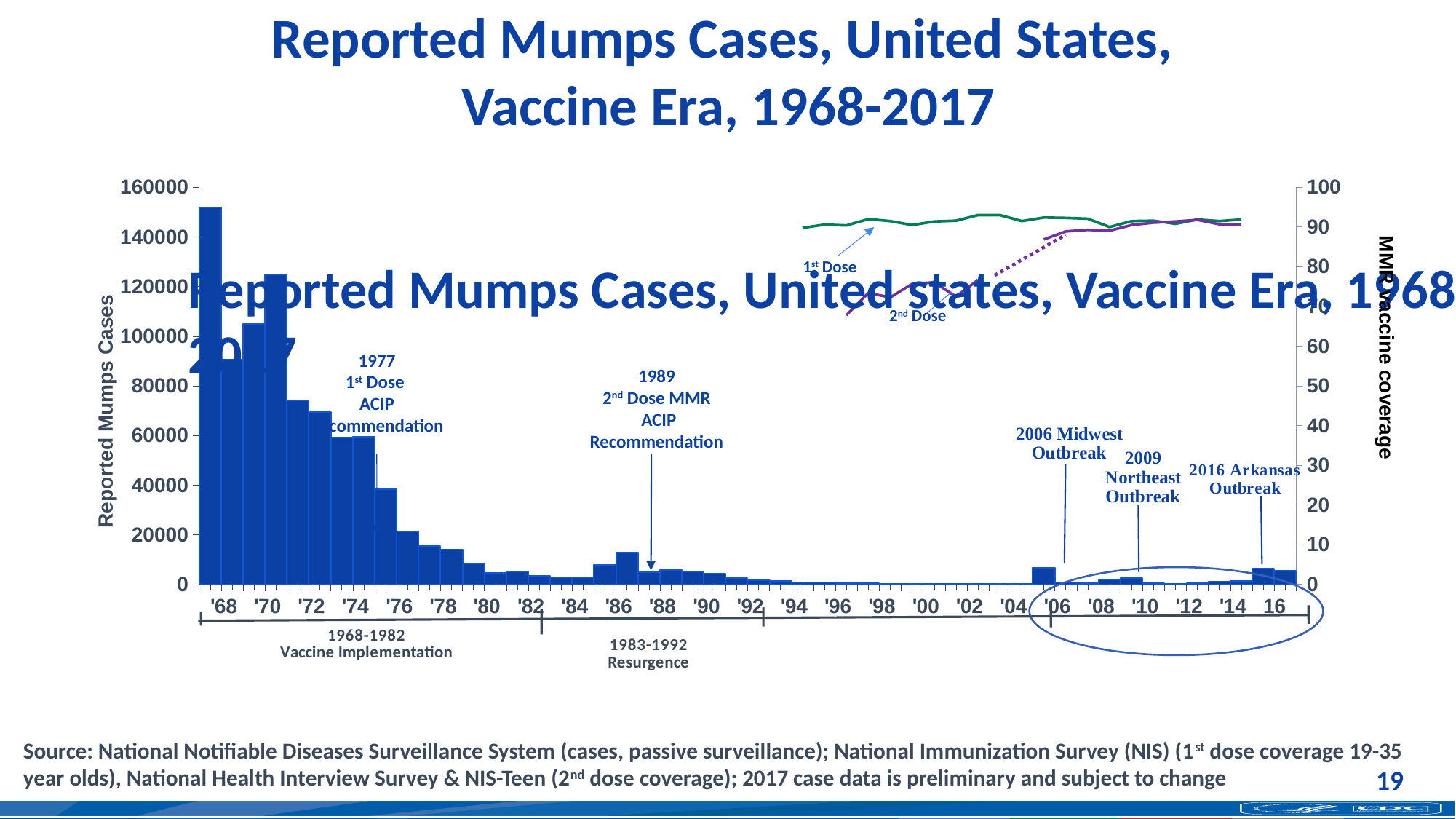
Which year has the highest number of reported mumps cases? 1968 Is the number of reported mumps cases in 1968 greater or less than 140000? greater Is the 1st dose MMR vaccine coverage shown by the green line greater or less than 80? greater What is the label of the left vertical axis? Reported Mumps Cases Which year had more reported mumps cases, 1986 or 1990? 1986 Is the number of reported mumps cases in 1986 greater or less than 20000? less What kind of chart is used to show the reported mumps cases on this slide? bar chart Which outbreak is annotated at 2016? 2016 Arkansas Outbreak Which year had more reported mumps cases, 1968 or 1970? 1968 Do reported mumps cases rise or fall from 1968 to 1982? fall